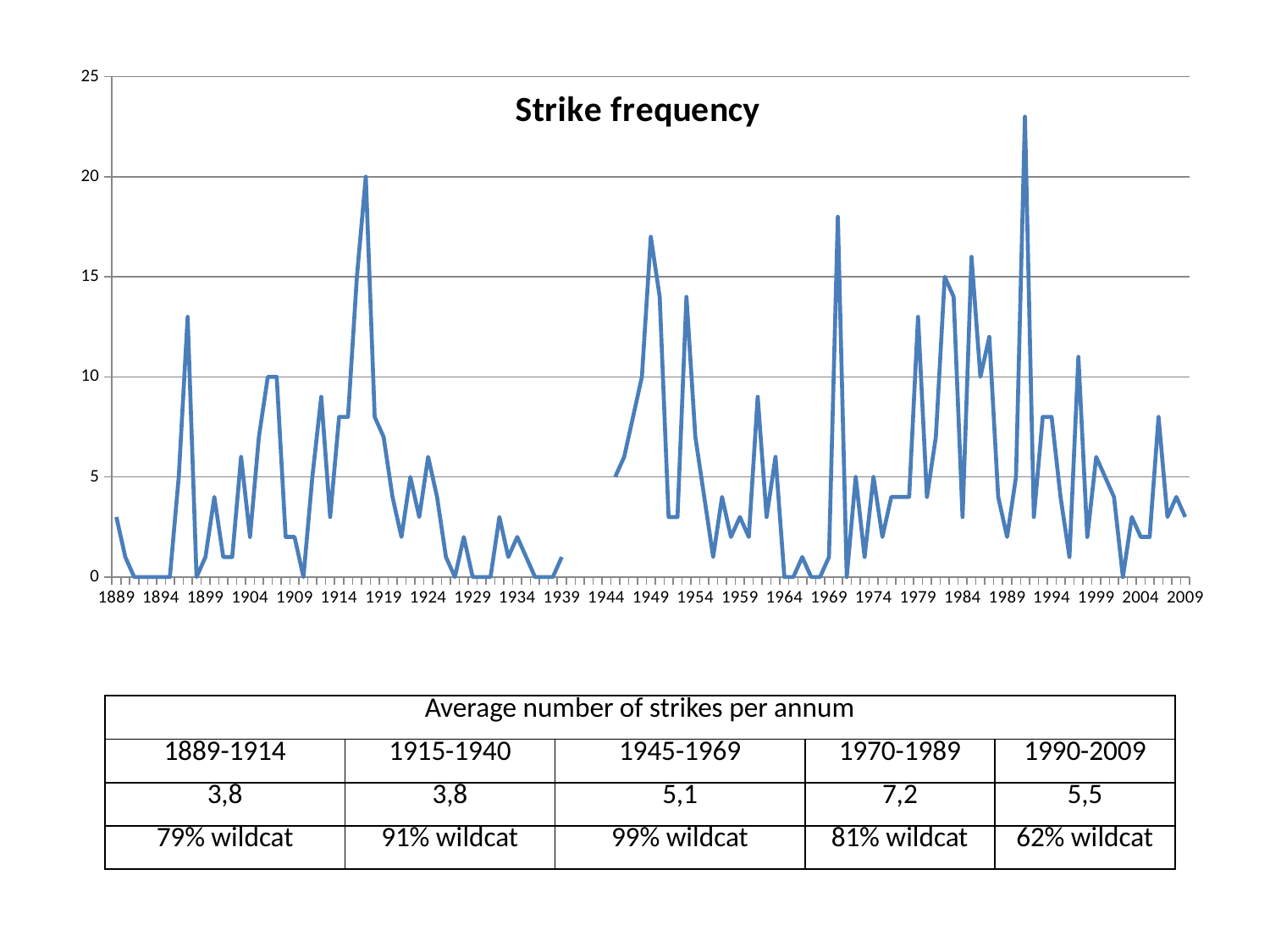
Do the strike frequency values rise or fall between 1944 and 1949? rise Is the strike frequency value for 1929 greater or less than 5? less Is the strike frequency value at the peak around 1949 greater or less than 15? greater What is the title of the chart? Strike frequency Do the strike frequency values rise or fall between 1917 and 1929? fall Is the strike frequency value for 1894 greater or less than 5? less What kind of chart is shown on the slide? line chart What is the highest value shown on the y axis of the chart? 25 Which is higher: the peak around 1991 or the peak around 1897? the peak around 1991 Which is higher: the peak around 1917 or the peak around 1949? the peak around 1917